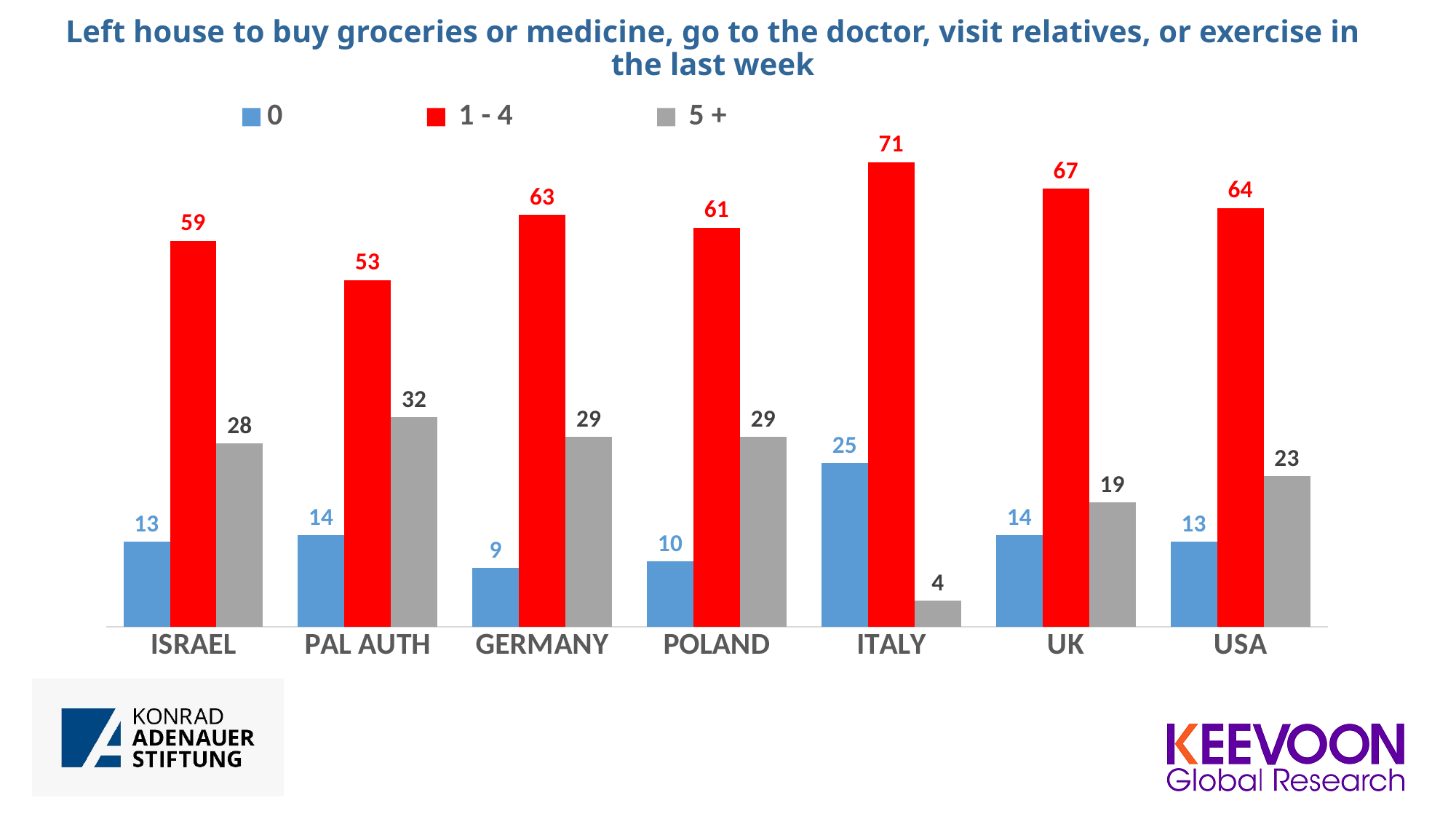
Which country has the highest value in the '1 - 4' series? Italy How many series does the legend list? 3 What is the value for the '0' series for Germany? 9 What is the difference between the '1 - 4' values for the UK and Israel? 8 How many countries are shown on the x axis? 7 What colour are the bars for the '1 - 4' series? Red What is the value for the '1 - 4' series for Italy? 71 Which country has the highest value in the '0' series? Italy What is the value for the '5 +' series for Pal Auth? 32 Which country has the lowest value in the '5 +' series? Italy What kind of chart is shown on the slide? Bar chart Which is larger: the '5 +' value for the USA or for the UK? USA